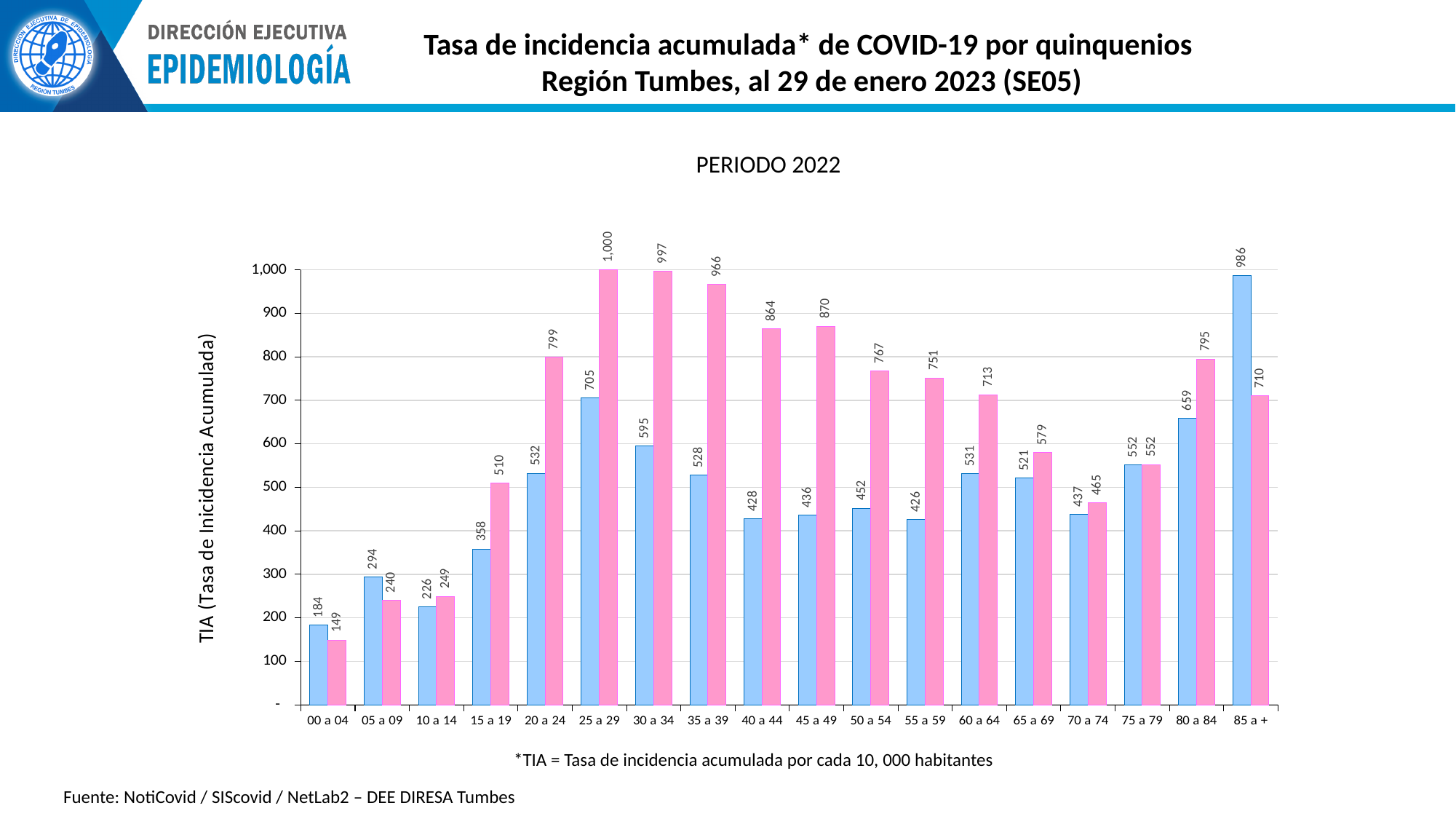
What is the value of the blue bar for the 25 a 29 age group? 705 For the 85 a + age group, how much larger is the blue bar than the pink bar? 276 For the 05 a 09 age group, which bar is larger, the blue or the pink? blue What kind of chart is shown on the slide? bar chart Which age group has the lowest pink bar? 00 a 04 Which age group has the highest pink bar? 25 a 29 Which age group has the lowest blue bar? 00 a 04 For the 20 a 24 age group, how much larger is the pink bar than the blue bar? 267 Which age group has the highest blue bar? 85 a + What is the value of the pink bar for the 85 a + age group? 710 What is the value of the pink bar for the 75 a 79 age group? 552 How many age groups are shown on the x axis? 18